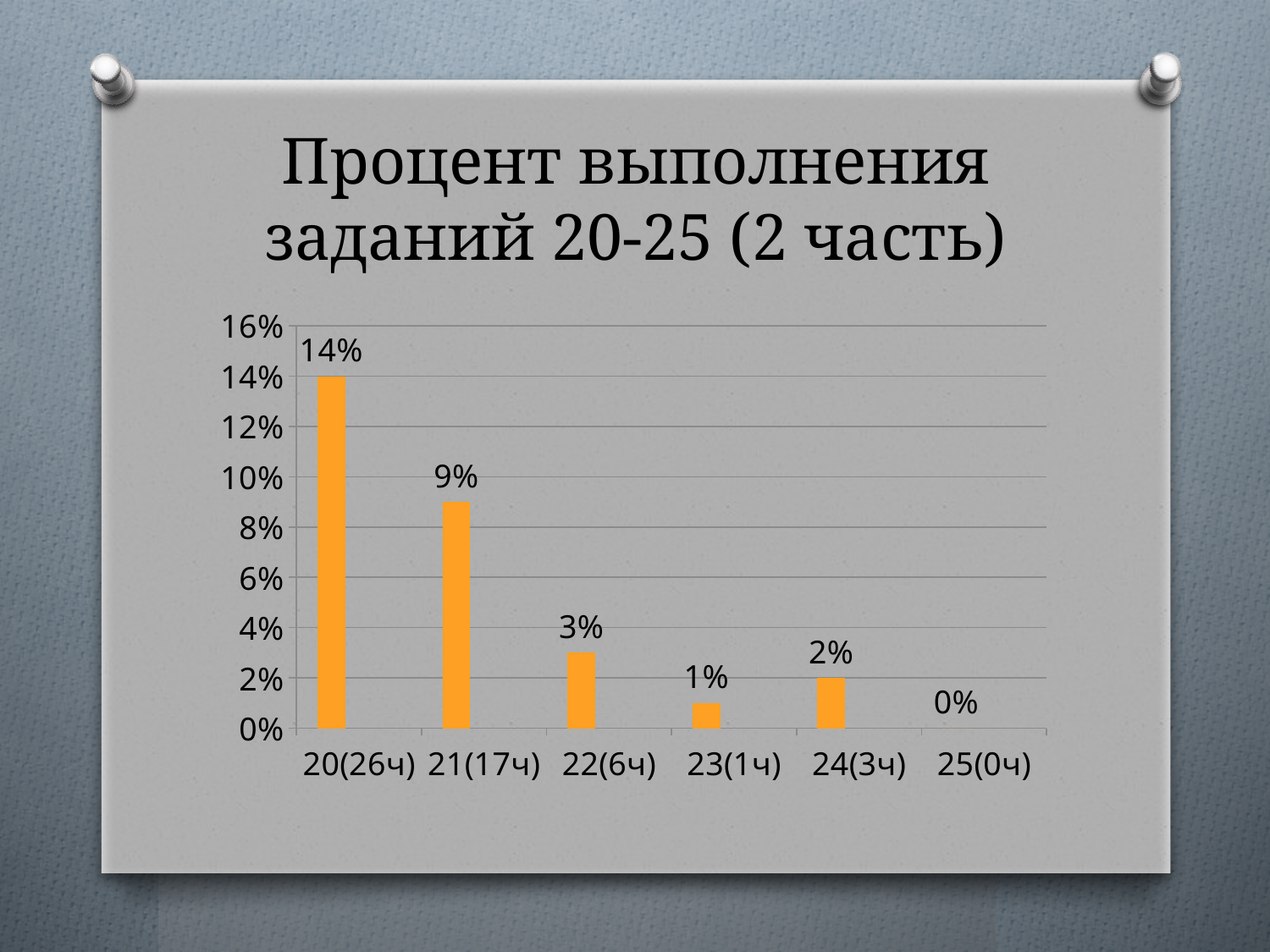
What is the value for 22(6ч)? 3% What is the value for 24(3ч)? 2% Is the value for 21(17ч) greater or less than 8%? greater Which category has the highest value? 20(26ч) What is the title of the chart? Процент выполнения заданий 20-25 (2 часть) How many categories are shown on the x axis? 6 What is the value for 20(26ч)? 14% What is the difference between the values for 20(26ч) and 21(17ч)? 5% Do the values generally rise or fall from 20(26ч) to 23(1ч)? fall Which category has the lowest value? 25(0ч) What kind of chart is shown on the slide? bar chart Which is larger, the value for 23(1ч) or the value for 24(3ч)? 24(3ч)